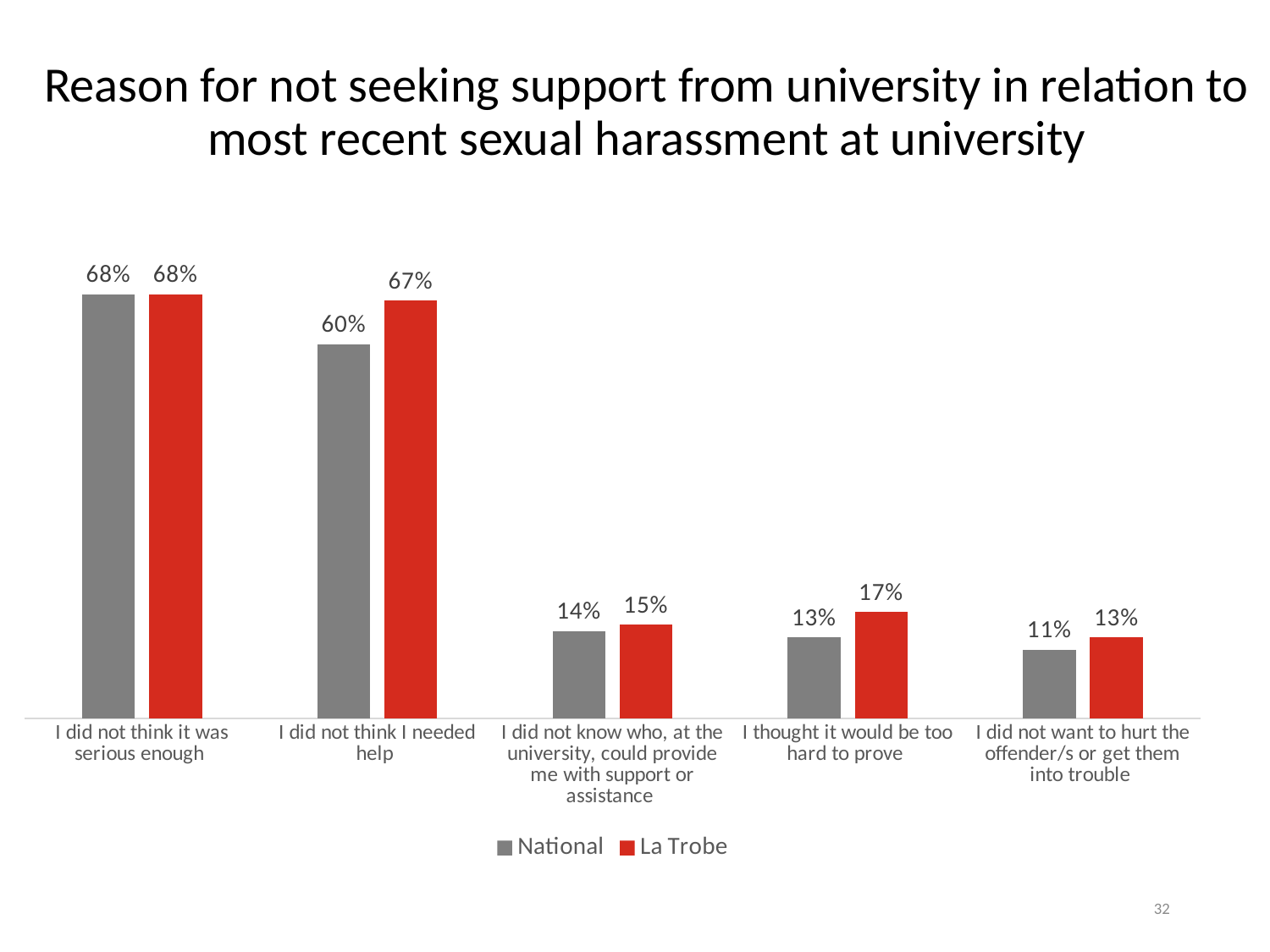
Which reason has the highest La Trobe value? I did not think it was serious enough For 'I did not want to hurt the offender/s or get them into trouble', which is larger, the National or La Trobe value? La Trobe What is the National value for 'I did not think I needed help'? 60% How many series does the legend list? 2 What is the La Trobe value for 'I did not want to hurt the offender/s or get them into trouble'? 13% How many reasons (categories) are shown on the chart? 5 What kind of chart is shown on the slide? Bar chart What is the difference between the La Trobe and National values for 'I thought it would be too hard to prove'? 4% What is the La Trobe value for 'I thought it would be too hard to prove'? 17% What is the difference between the La Trobe and National values for 'I did not think I needed help'? 7% What is the National value for 'I did not know who, at the university, could provide me with support or assistance'? 14% Which reason has the lowest National value? I did not want to hurt the offender/s or get them into trouble